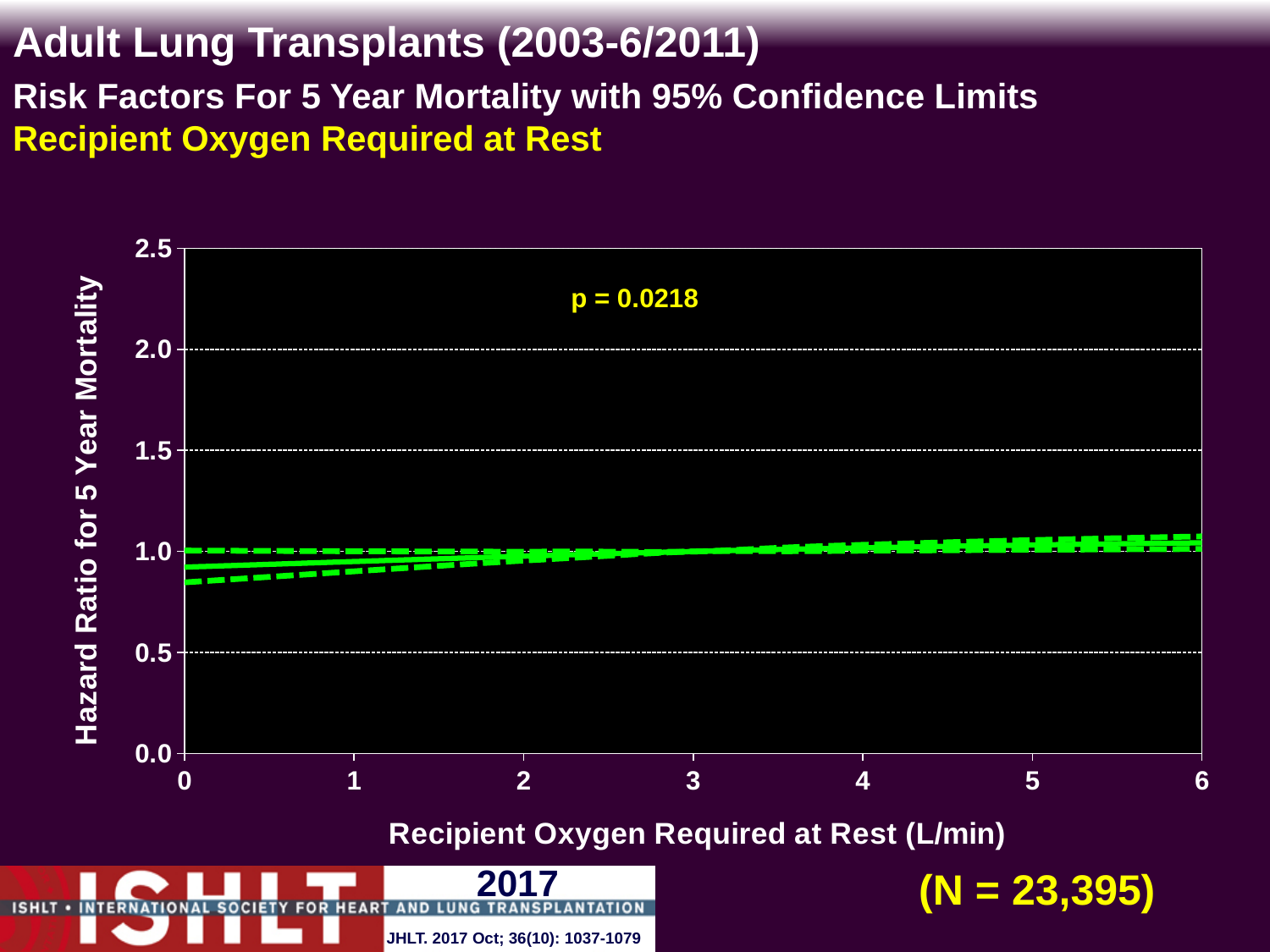
What is the sample size (N) shown on the slide? 23,395 What is the highest value labelled on the y axis? 2.5 Is the hazard ratio at 6 L/min greater or less than 1.5? less How many lines (solid and dashed) are plotted on the chart? 3 What kind of chart is shown on the slide? line chart What is the highest value labelled on the x axis? 6 What p-value is printed on the chart? p = 0.0218 Is the hazard ratio at 3 L/min greater or less than 2.0? less Is the hazard ratio at 0 L/min greater or less than 0.5? greater Does the hazard ratio for 5 year mortality rise or fall as recipient oxygen required at rest increases from 0 to 6 L/min? rise